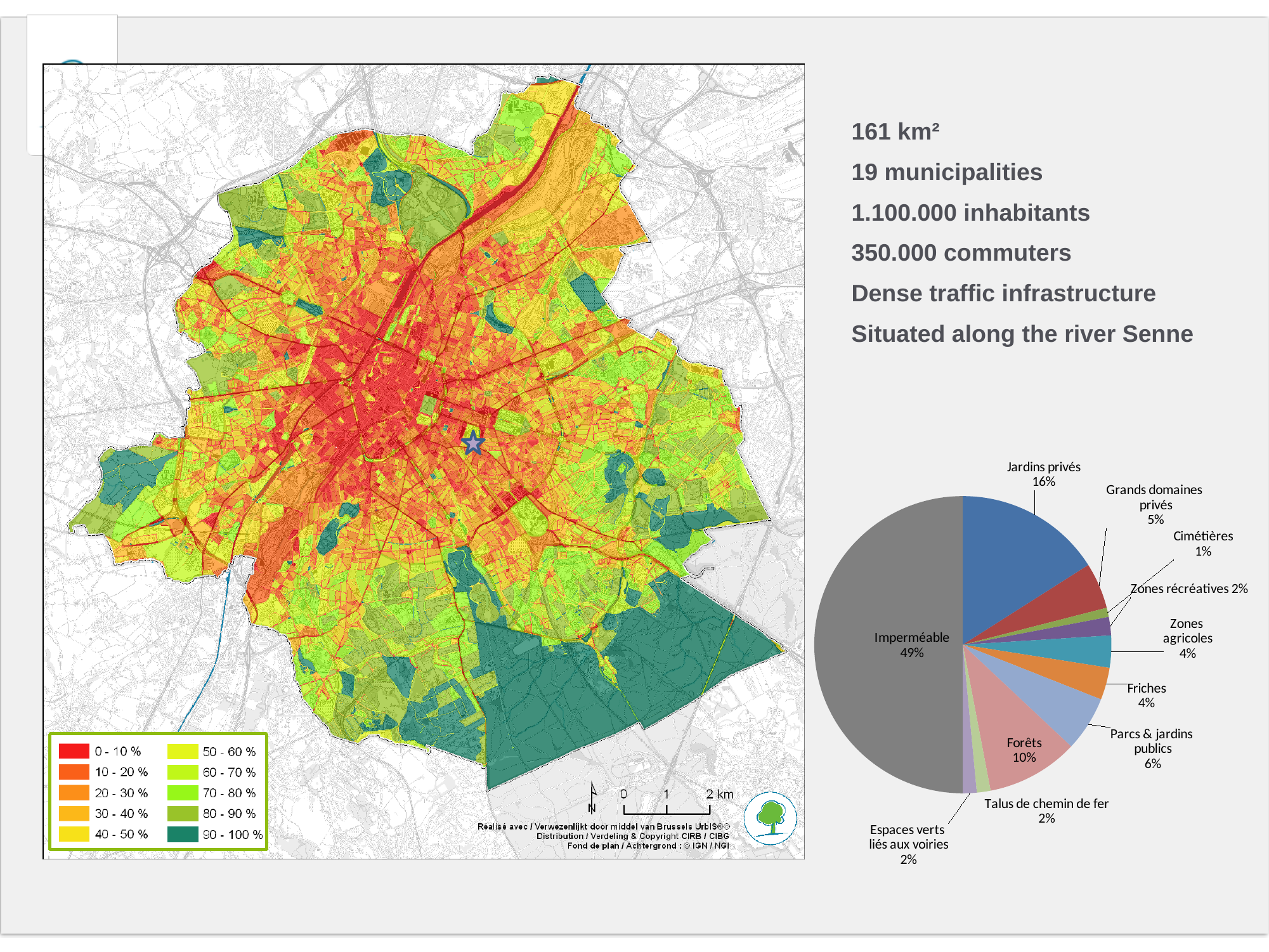
On the pie chart, what percentage is shown for Parcs & jardins publics? 6% On the pie chart, what colour is the Imperméable slice? Grey On the pie chart, what share is labelled for Imperméable? 49% On the pie chart, which is larger: Forêts or Grands domaines privés? Forêts How many slices does the pie chart have? 11 On the pie chart, what is the difference in percentage points between Imperméable and Jardins privés? 33 On the pie chart, what percentage is shown for Forêts? 10% On the pie chart, what percentage is shown for Jardins privés? 16% On the pie chart, which category has the largest slice? Imperméable On the pie chart, which category has the smallest slice? Cimétières What kind of chart is shown on the right side of the slide? Pie chart On the pie chart, what percentage is shown for Zones agricoles? 4%